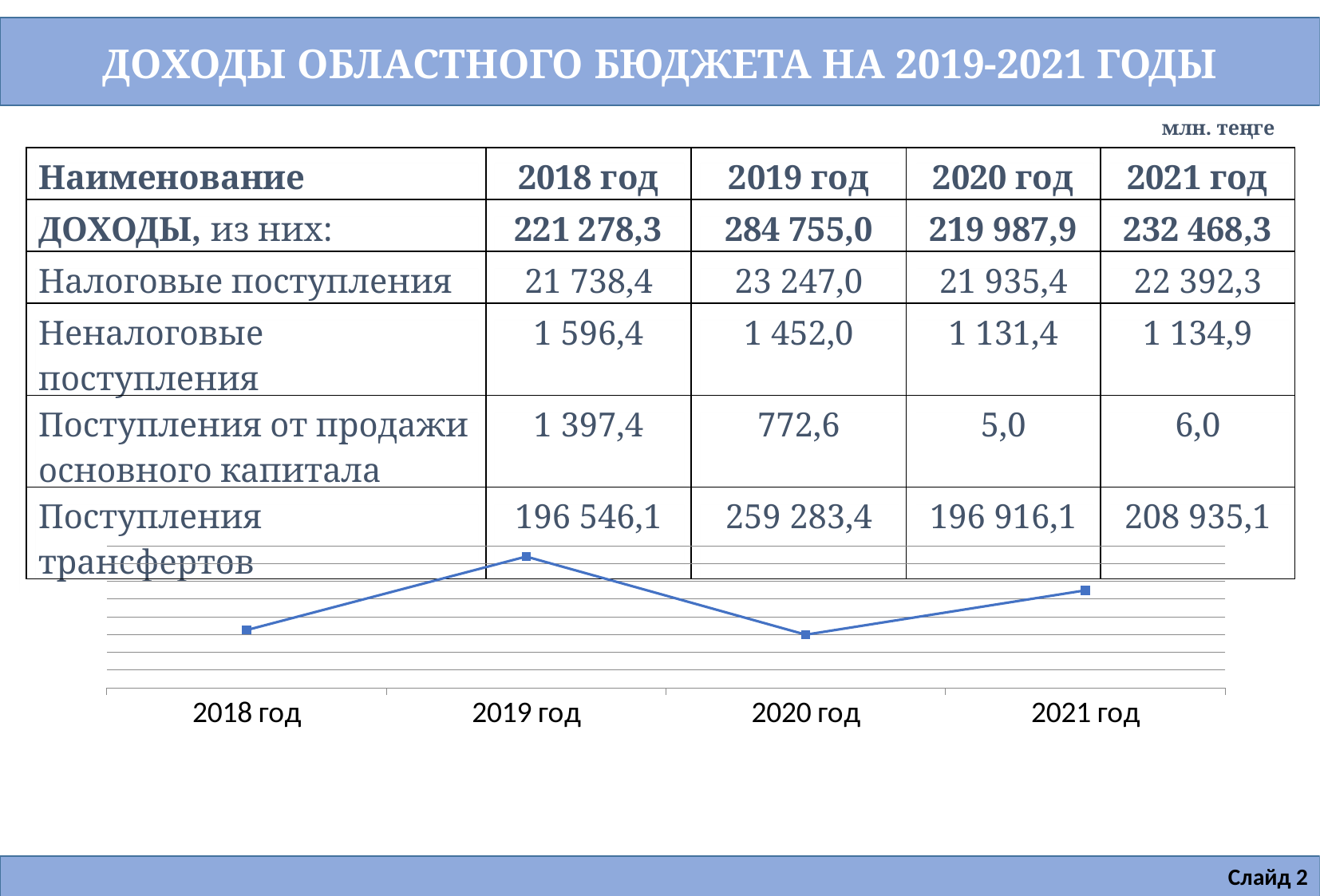
Does the line rise or fall from 2019 год to 2020 год? fall On the line chart, which is higher: the point for 2018 год or the point for 2021 год? 2021 год Does the line rise or fall from 2018 год to 2019 год? rise Does the line rise or fall from 2020 год to 2021 год? rise Which year has the lowest point on the line chart? 2020 год On the line chart, which is higher: the point for 2019 год or the point for 2020 год? 2019 год What kind of chart is shown below the table on the slide? line chart How many data points are plotted on the line chart? 4 Which year has the highest point on the line chart? 2019 год What are the category labels on the x axis of the line chart? 2018 год, 2019 год, 2020 год, 2021 год What colour is the line on the chart? blue